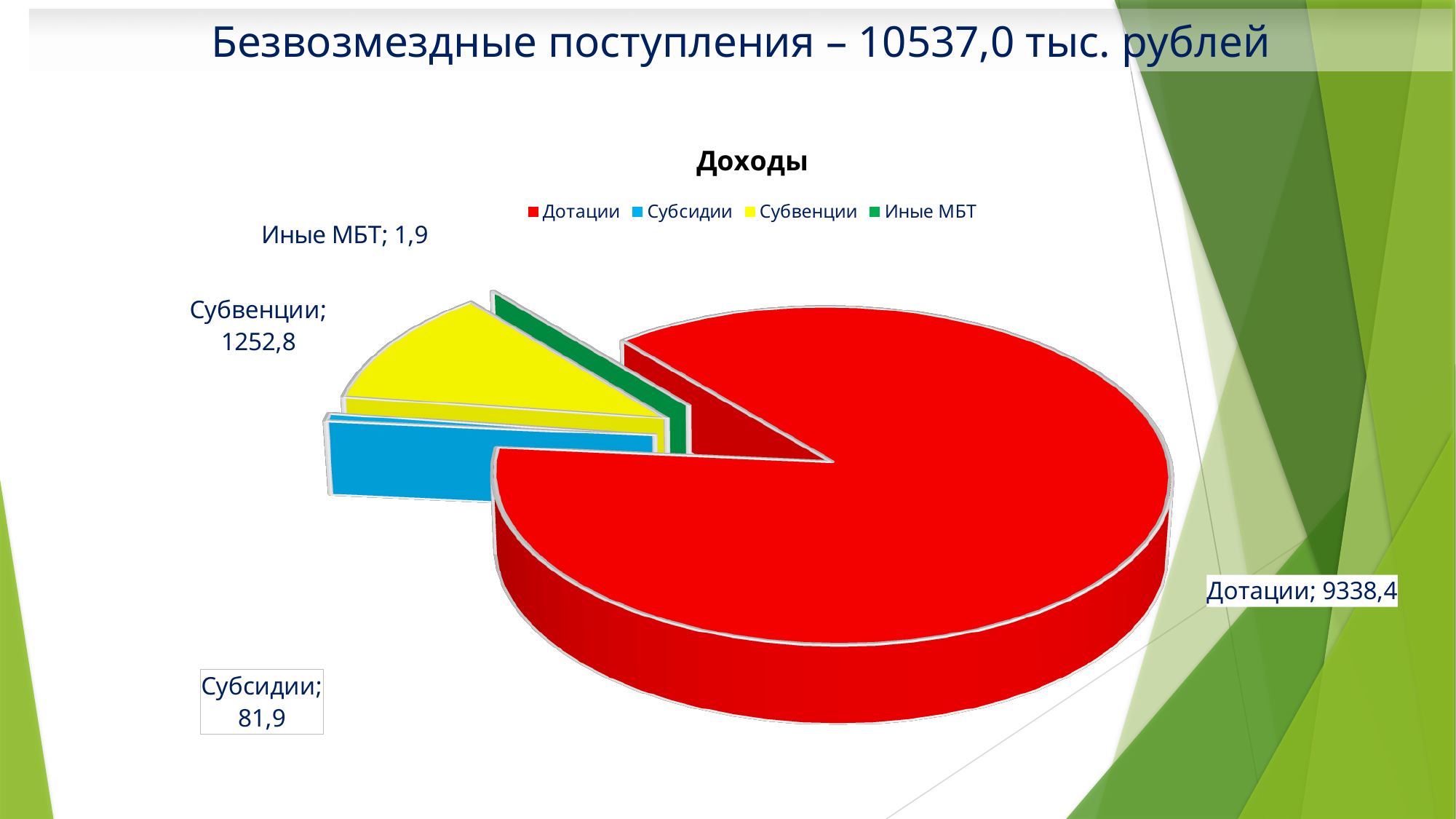
What kind of chart is shown on the slide? pie chart Which category has the lowest value? Иные МБТ What is the title of the chart? Доходы What is the value for Иные МБТ? 1,9 Which category has the highest value? Дотации What is the difference between the values for Дотации and Субвенции? 8085,6 What is the value for Субвенции? 1252,8 Which colour represents Субвенции in the chart? yellow How many slices does the pie chart have? 4 What is the value for Дотации? 9338,4 How many entries does the legend list? 4 What is the value for Субсидии? 81,9